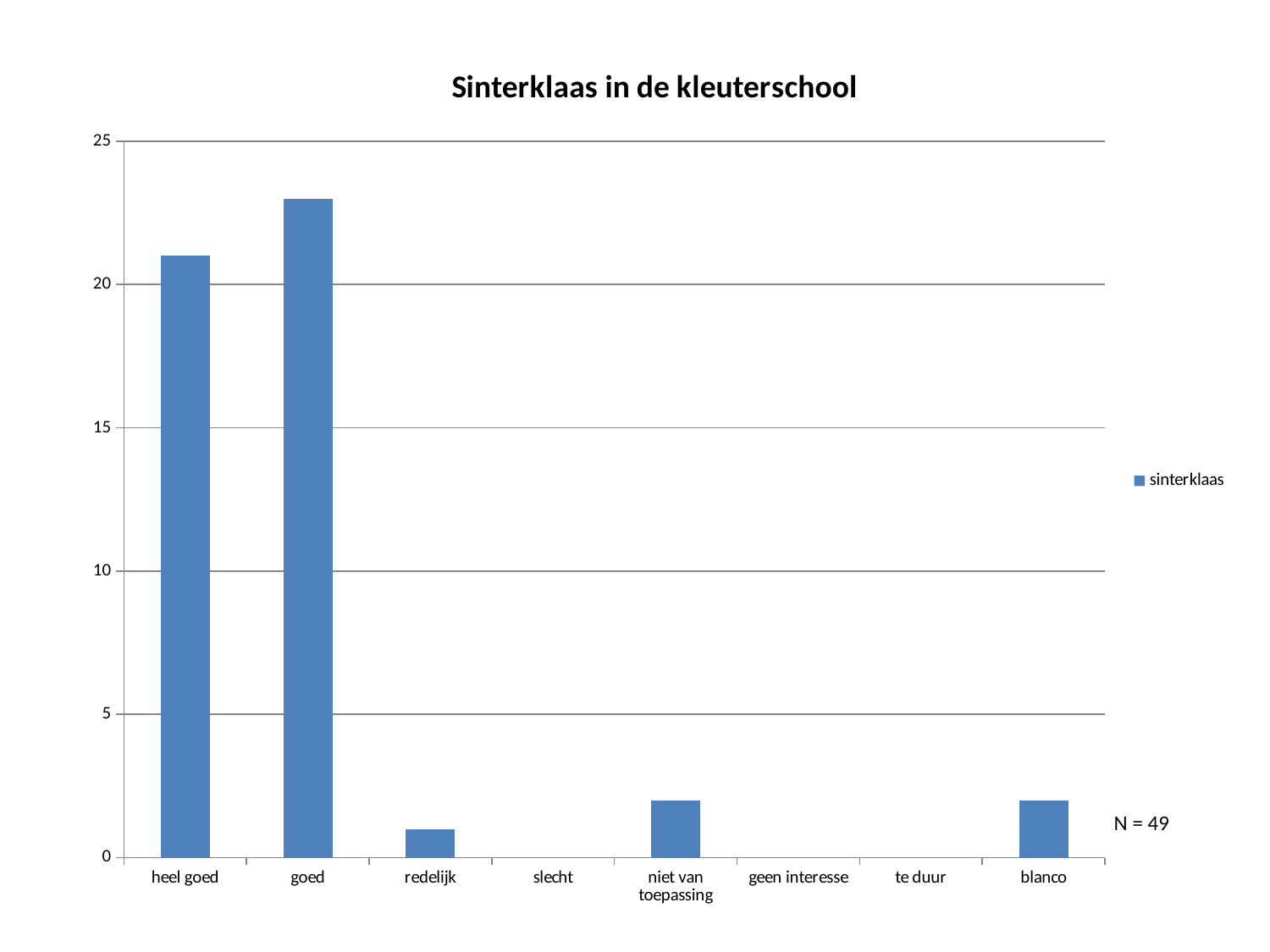
What is the name of the series shown in the legend? sinterklaas What kind of chart is shown on the slide? bar chart Is the value for heel goed greater or less than 20? greater Is the value for blanco greater or less than 5? less Is the value for goed greater or less than 25? less Which is larger, the value for goed or the value for heel goed? goed What is the title of the chart? Sinterklaas in de kleuterschool How many categories are shown on the x axis of the chart? 8 Which is larger, the value for niet van toepassing or the value for redelijk? niet van toepassing Which category has the highest value? goed How many series does the legend list? 1